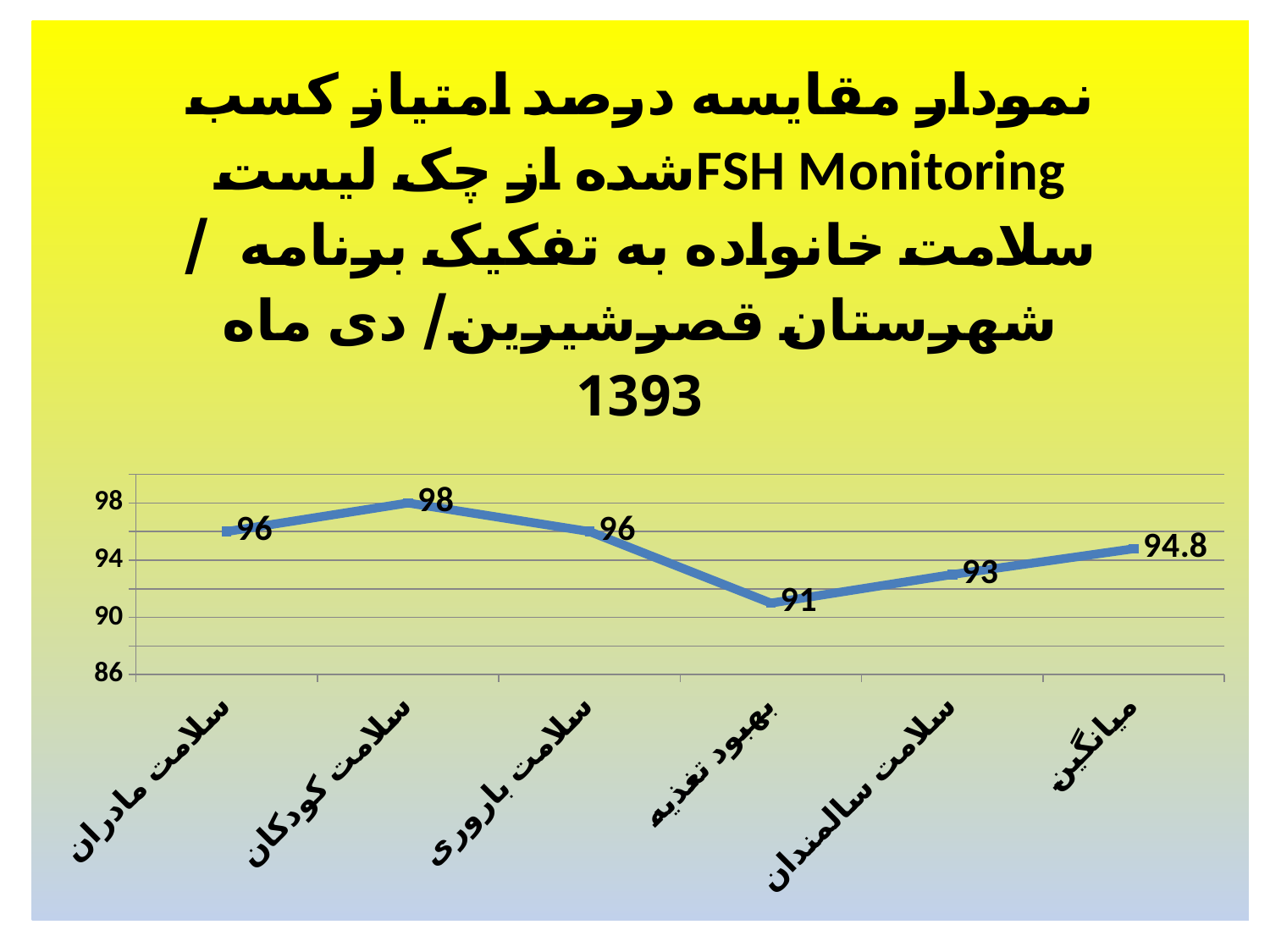
Is the value for سلامت سالمندان greater or less than 94? less What is the value for بهبود تغذیه? 91 Which category has the lowest value? بهبود تغذیه What is the value for میانگین? 94.8 What is the value for سلامت مادران? 96 Which category has the highest value? سلامت کودکان What is the value for سلامت کودکان? 98 What is the difference between the values for سلامت کودکان and بهبود تغذیه? 7 How many categories are plotted on the x axis? 6 Which is larger, the value for سلامت سالمندان or the value for سلامت باروری? سلامت باروری What kind of chart is shown on the slide? line chart Do the values rise or fall from سلامت باروری to بهبود تغذیه? fall